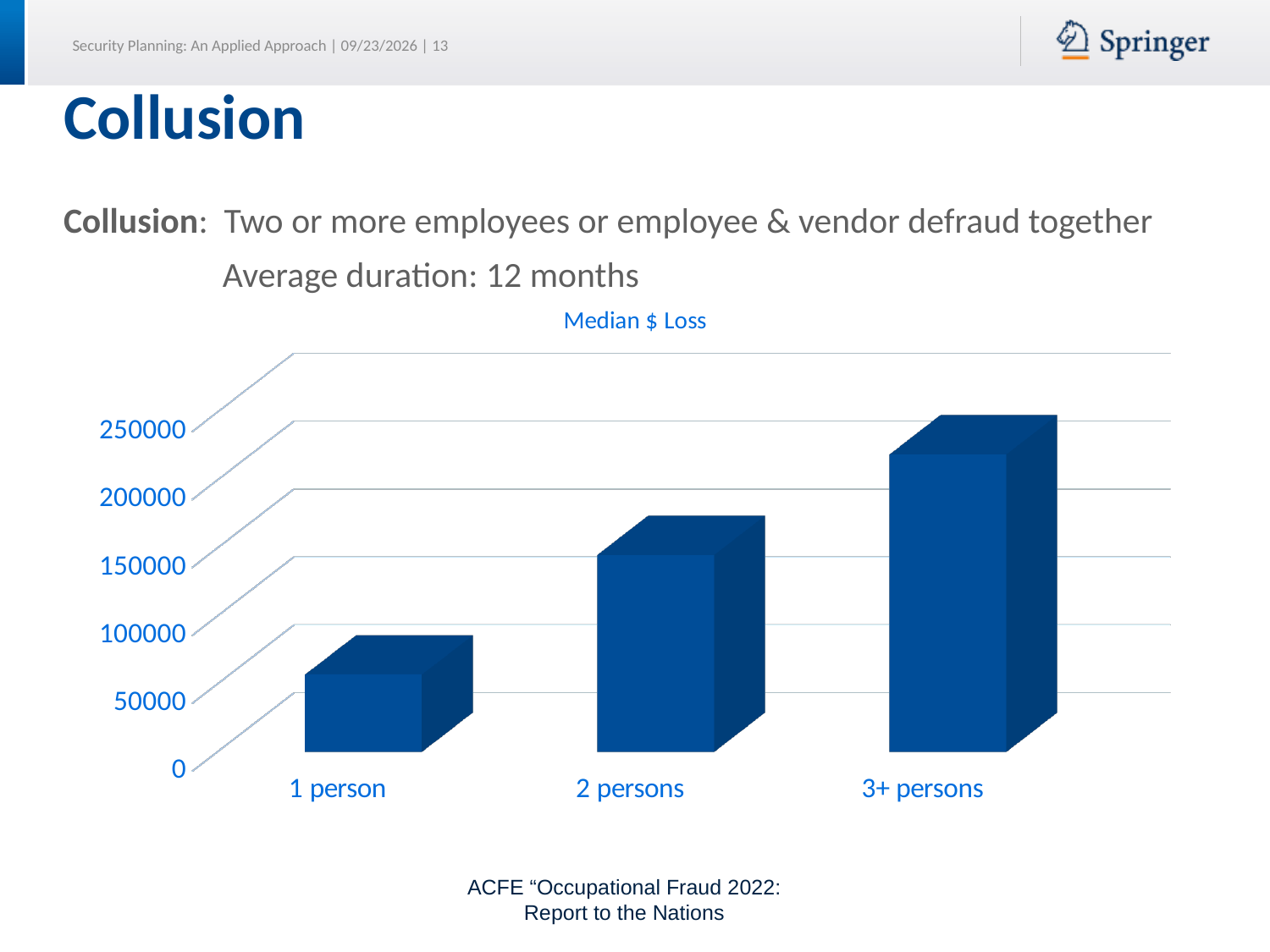
What is the title of the chart? Median $ Loss What kind of chart is shown on the slide? bar chart Which has a larger median $ loss, 2 persons or 3+ persons? 3+ persons Is the value for 2 persons greater or less than 100000? greater Do the values rise or fall moving from 1 person to 3+ persons along the x axis? rise Is the value for 1 person greater or less than 100000? less Which has a larger median $ loss, 1 person or 2 persons? 2 persons Which category has the lowest median $ loss? 1 person Is the value for 3+ persons greater or less than 200000? greater How many categories are shown on the x axis of the chart? 3 Which category has the highest median $ loss? 3+ persons